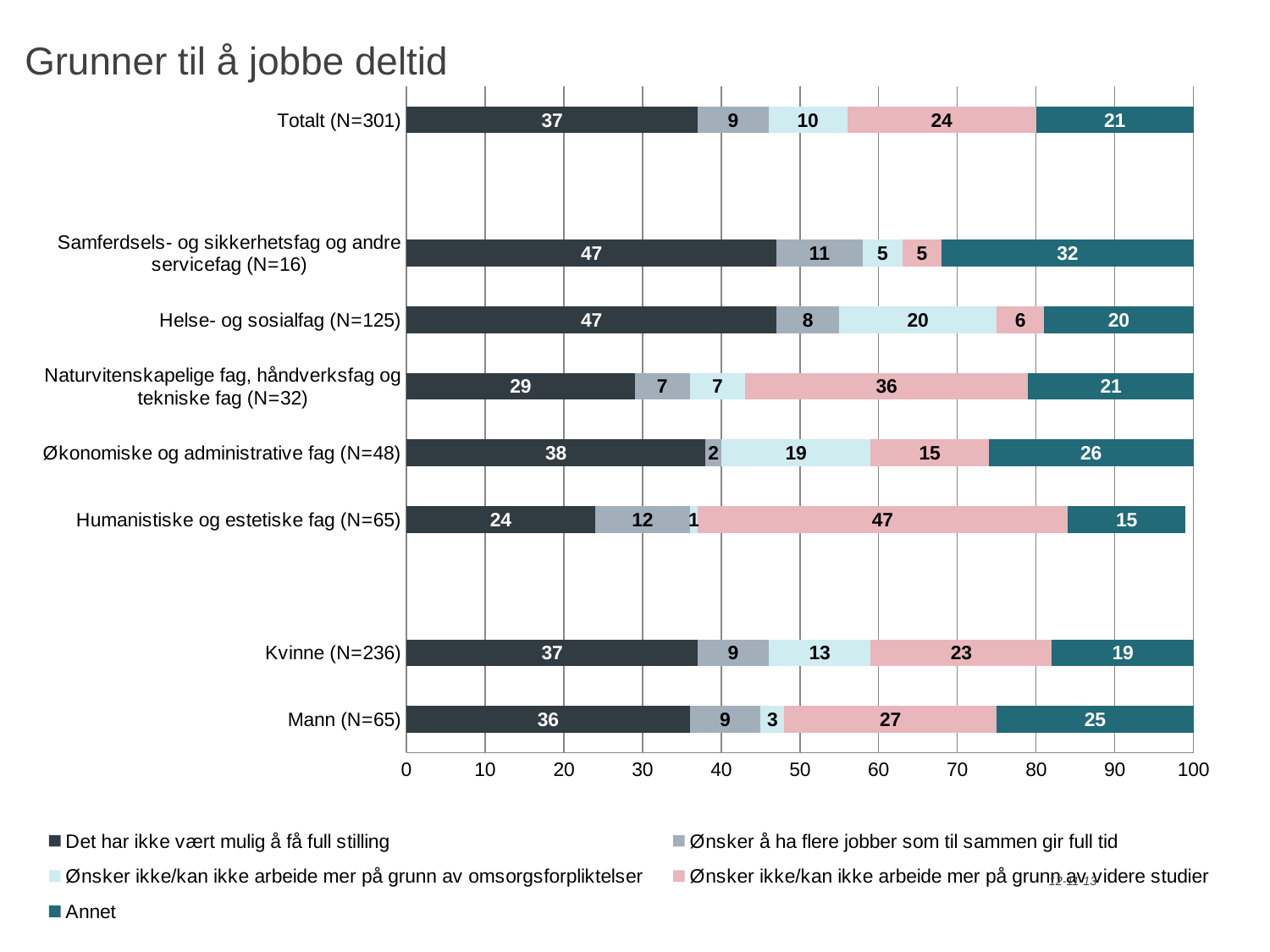
Which category has the highest value for 'Ønsker ikke/kan ikke arbeide mer på grunn av videre studier'? Humanistiske og estetiske fag (N=65) What is the value of 'Annet' for Mann (N=65)? 25 What is the total of the stacked bar for Totalt (N=301)? 101 Which category has the lowest value for 'Det har ikke vært mulig å få full stilling'? Humanistiske og estetiske fag (N=65) How many series does the legend list? 5 What is the title of the chart? Grunner til å jobbe deltid How many categories are plotted on the chart? 8 What is the value of 'Det har ikke vært mulig å få full stilling' for Helse- og sosialfag (N=125)? 47 What is the difference between the 'Annet' values for Samferdsels- og sikkerhetsfag og andre servicefag (N=16) and Totalt (N=301)? 11 Which is larger: the 'Ønsker ikke/kan ikke arbeide mer på grunn av omsorgsforpliktelser' value for Kvinne (N=236) or for Mann (N=65)? Kvinne (N=236) What is the value of 'Ønsker ikke/kan ikke arbeide mer på grunn av videre studier' for Humanistiske og estetiske fag (N=65)? 47 What type of chart is shown on the slide? Stacked bar chart